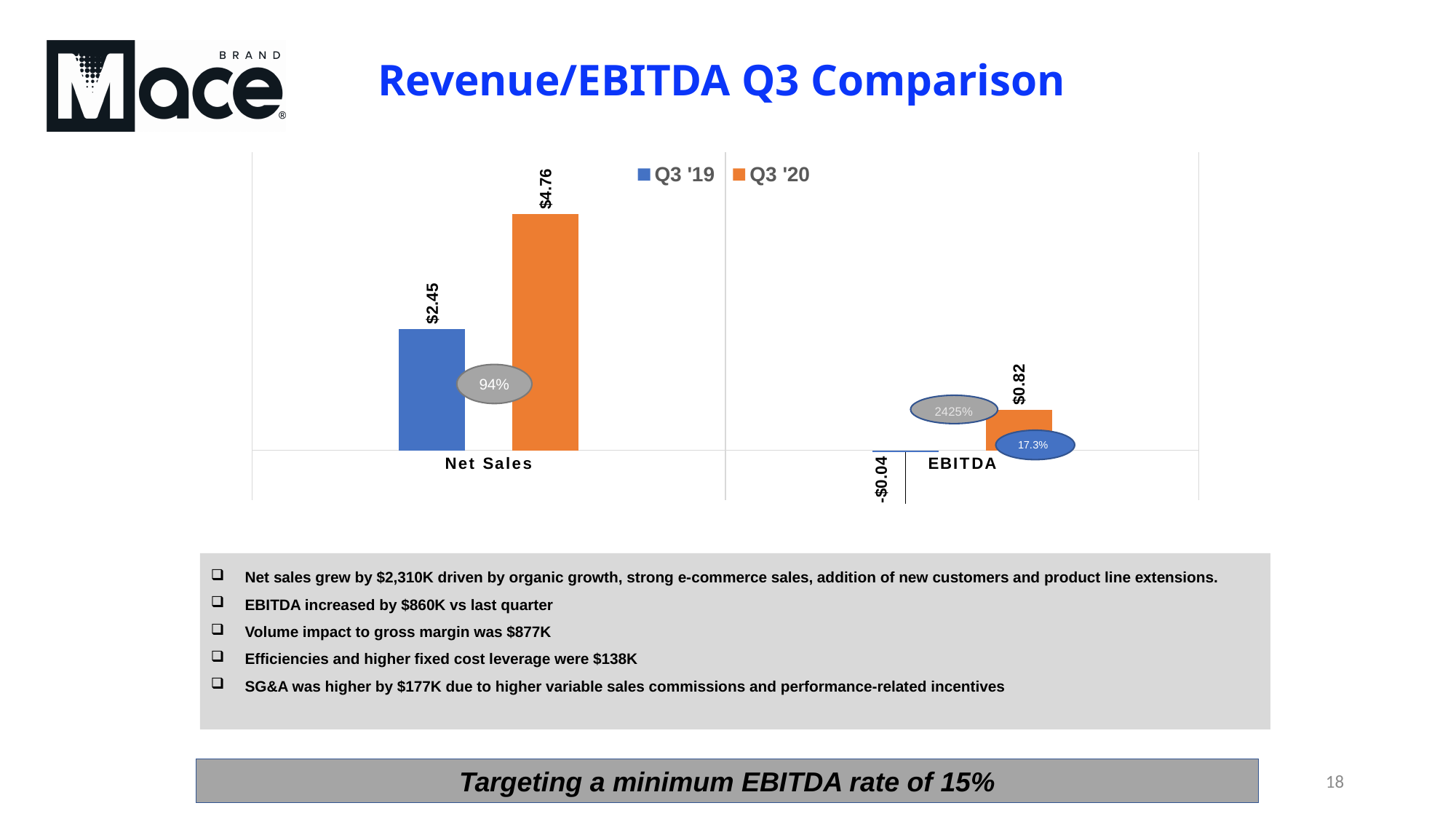
What is the Net Sales value for Q3 '19? $2.45 What is the Net Sales value for Q3 '20? $4.76 How many categories are shown on the x axis of the chart? 2 How many series does the chart legend list? 2 What colour are the Q3 '20 bars in the chart? orange Which series has the higher Net Sales value, Q3 '19 or Q3 '20? Q3 '20 What is the EBITDA value for Q3 '20? $0.82 Which bar in the chart has the lowest value? EBITDA Q3 '19 What is the difference between the Q3 '20 and Q3 '19 Net Sales values? $2.31 What is the EBITDA value for Q3 '19? -$0.04 What is the difference between the Q3 '20 and Q3 '19 EBITDA values? $0.86 What type of chart is shown on the slide? bar chart